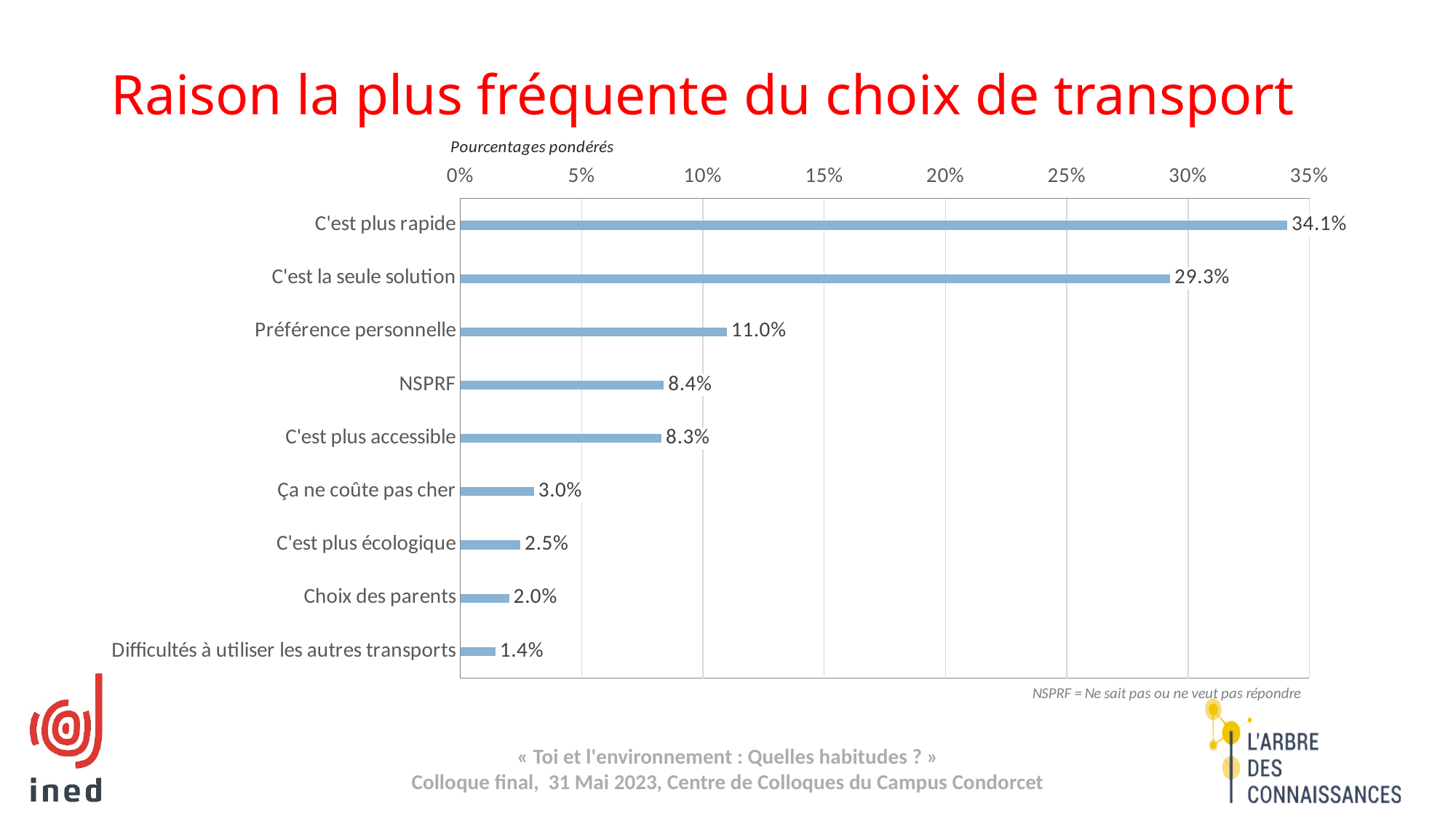
Which category has the highest value? C'est plus rapide What is the value for "Choix des parents"? 2.0% Which category has the lowest value? Difficultés à utiliser les autres transports Which is larger, "Ça ne coûte pas cher" or "C'est plus écologique"? Ça ne coûte pas cher What is the title of the slide? Raison la plus fréquente du choix de transport Is the value for "C'est la seule solution" greater or less than 25%? greater What is the value for "Préférence personnelle"? 11.0% What kind of chart is shown on the slide? Bar chart What is the value for "C'est plus rapide"? 34.1% How many categories are shown in the chart? 9 What is the difference between "C'est plus rapide" and "C'est la seule solution"? 4.8% According to the note below the chart, what does NSPRF stand for? Ne sait pas ou ne veut pas répondre